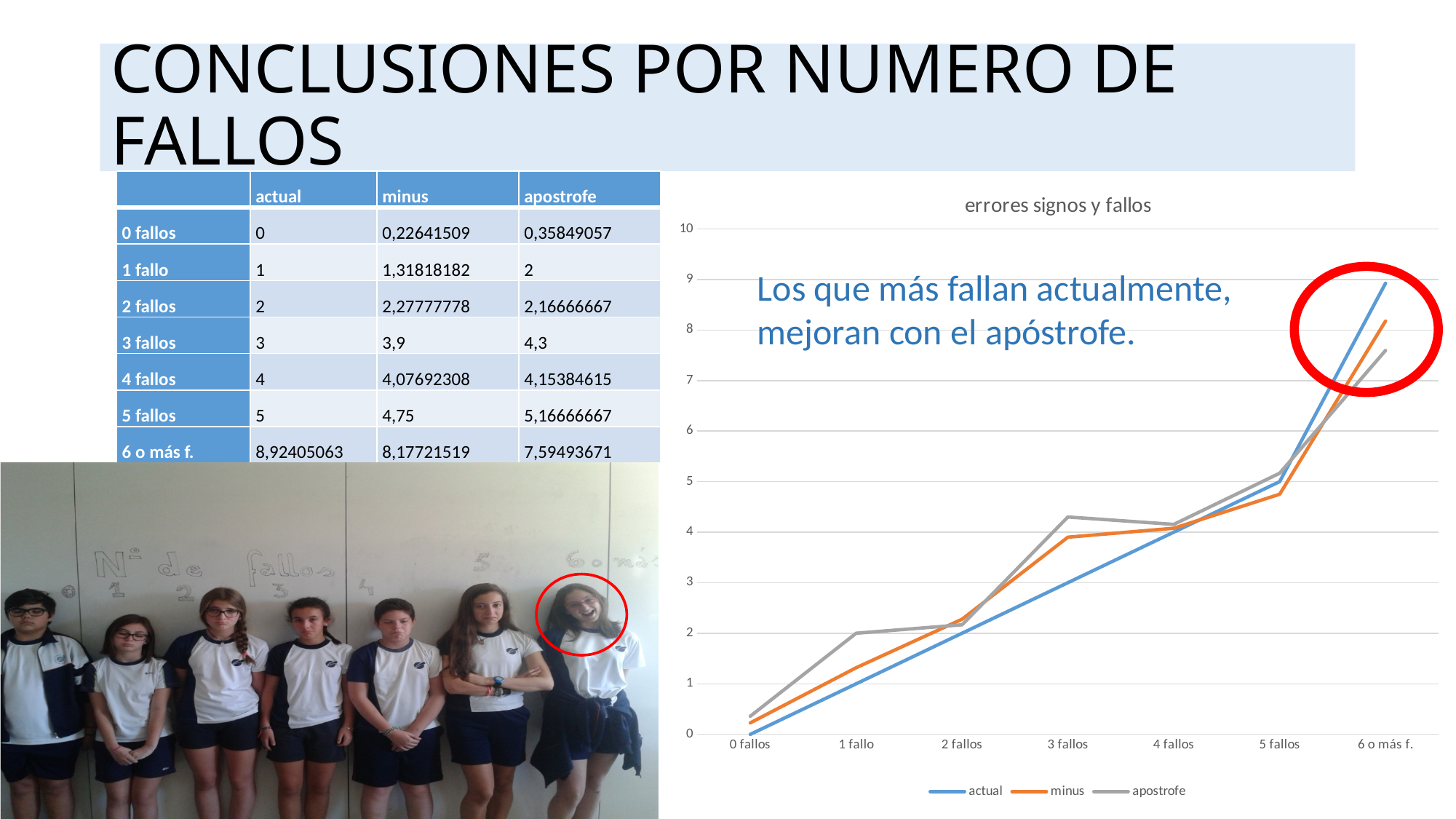
How many series does the legend of the chart list? 3 What kind of chart is shown on the slide? line chart What is the value of the 'actual' series at '6 o más f.'? 8,92405063 What is the title of the chart? errores signos y fallos For which category is the 'actual' series lowest? 0 fallos What is the value of the 'apostrofe' series at '3 fallos'? 4,3 How many categories are shown along the x axis of the chart? 7 Does the 'actual' series rise or fall from '0 fallos' to '6 o más f.'? rise Is the value of the 'minus' series at '3 fallos' greater or less than 3? greater At '6 o más f.', which series has the larger value, 'actual' or 'apostrofe'? actual What is the difference between the 'actual' and 'apostrofe' values at '6 o más f.'? 1,32911392 For which category is the 'minus' series highest? 6 o más f.